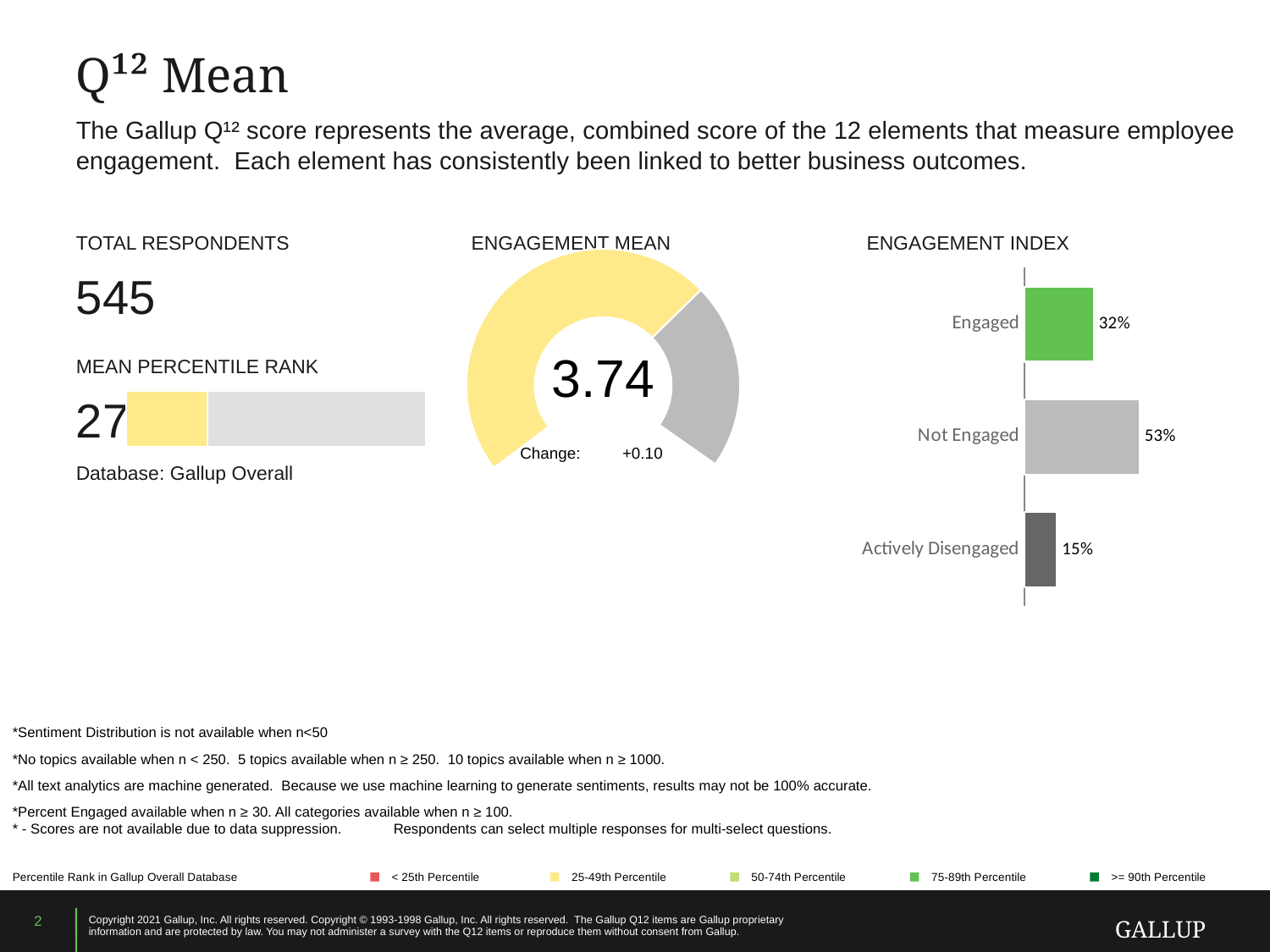
In the Engagement Index chart, what is the value for Engaged? 32% In the Engagement Index chart, what is the difference between Not Engaged and Engaged? 21% In the Engagement Index chart, what is the value for Actively Disengaged? 15% In the Engagement Index chart, what is the value for Not Engaged? 53% How many categories does the Engagement Index chart show? 3 What value is shown in the centre of the Engagement Mean gauge chart? 3.74 In the Engagement Index chart, what colour is the Engaged bar? Green In the Engagement Index chart, which is larger: Engaged or Actively Disengaged? Engaged What kind of chart is the Engagement Index chart? Bar chart In the Engagement Index chart, which category has the highest value? Not Engaged In the Engagement Index chart, which category has the lowest value? Actively Disengaged What change is shown below the value in the Engagement Mean gauge chart? +0.10